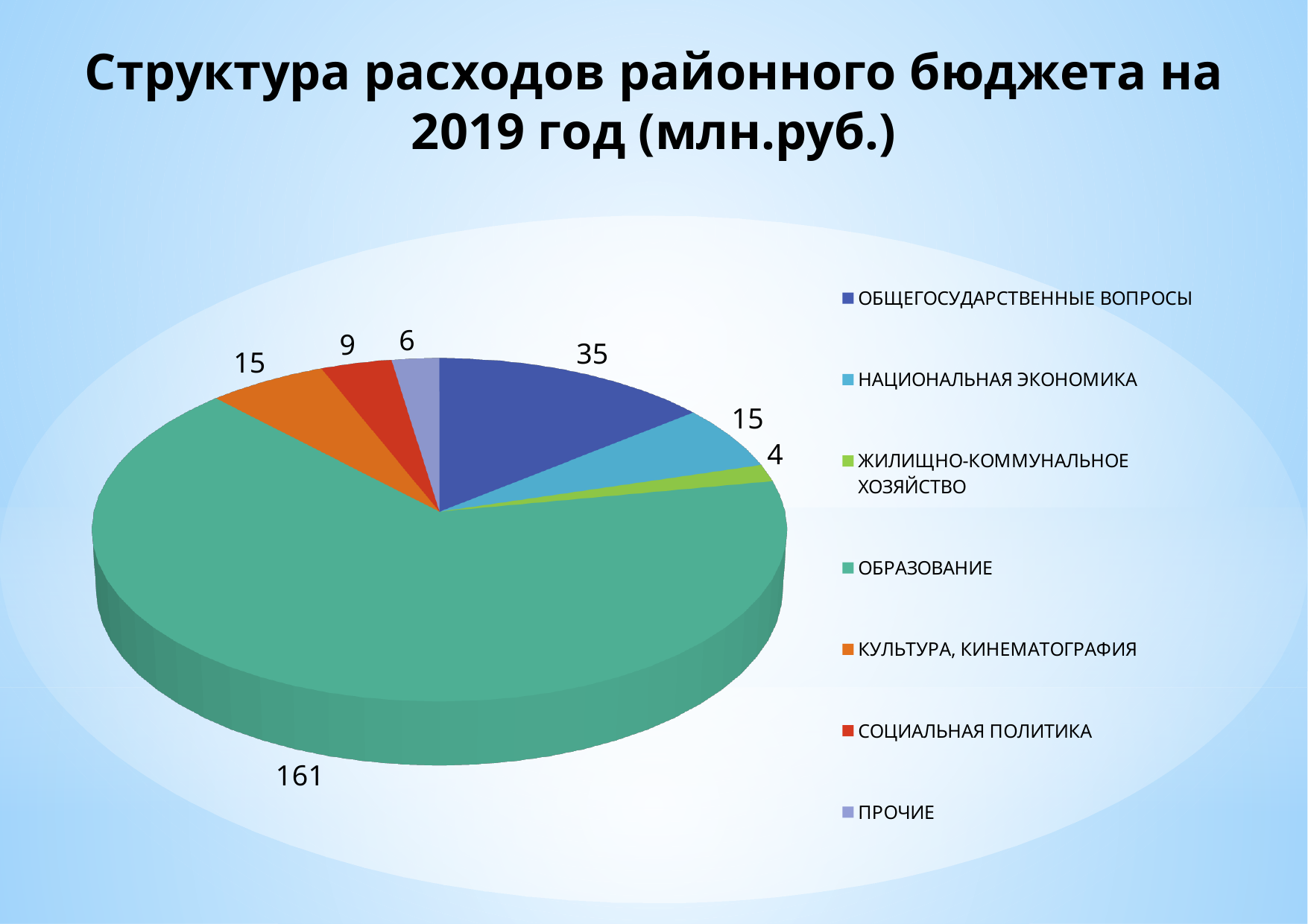
What is the title of the chart on the slide? Структура расходов районного бюджета на 2019 год (млн.руб.) Which category has the smallest slice of the pie? ЖИЛИЩНО-КОММУНАЛЬНОЕ ХОЗЯЙСТВО Which category has the largest slice of the pie? ОБРАЗОВАНИЕ What is the value for ОБРАЗОВАНИЕ? 161 Which is larger, the value for СОЦИАЛЬНАЯ ПОЛИТИКА or the value for ПРОЧИЕ? СОЦИАЛЬНАЯ ПОЛИТИКА What type of chart is shown on the slide? Pie chart How many categories does the pie chart have? 7 What is the difference between the values for ОБРАЗОВАНИЕ and ОБЩЕГОСУДАРСТВЕННЫЕ ВОПРОСЫ? 126 What is the value for ОБЩЕГОСУДАРСТВЕННЫЕ ВОПРОСЫ? 35 What is the value for ЖИЛИЩНО-КОММУНАЛЬНОЕ ХОЗЯЙСТВО? 4 What is the value for СОЦИАЛЬНАЯ ПОЛИТИКА? 9 What is the total of all the slices in the pie chart? 245